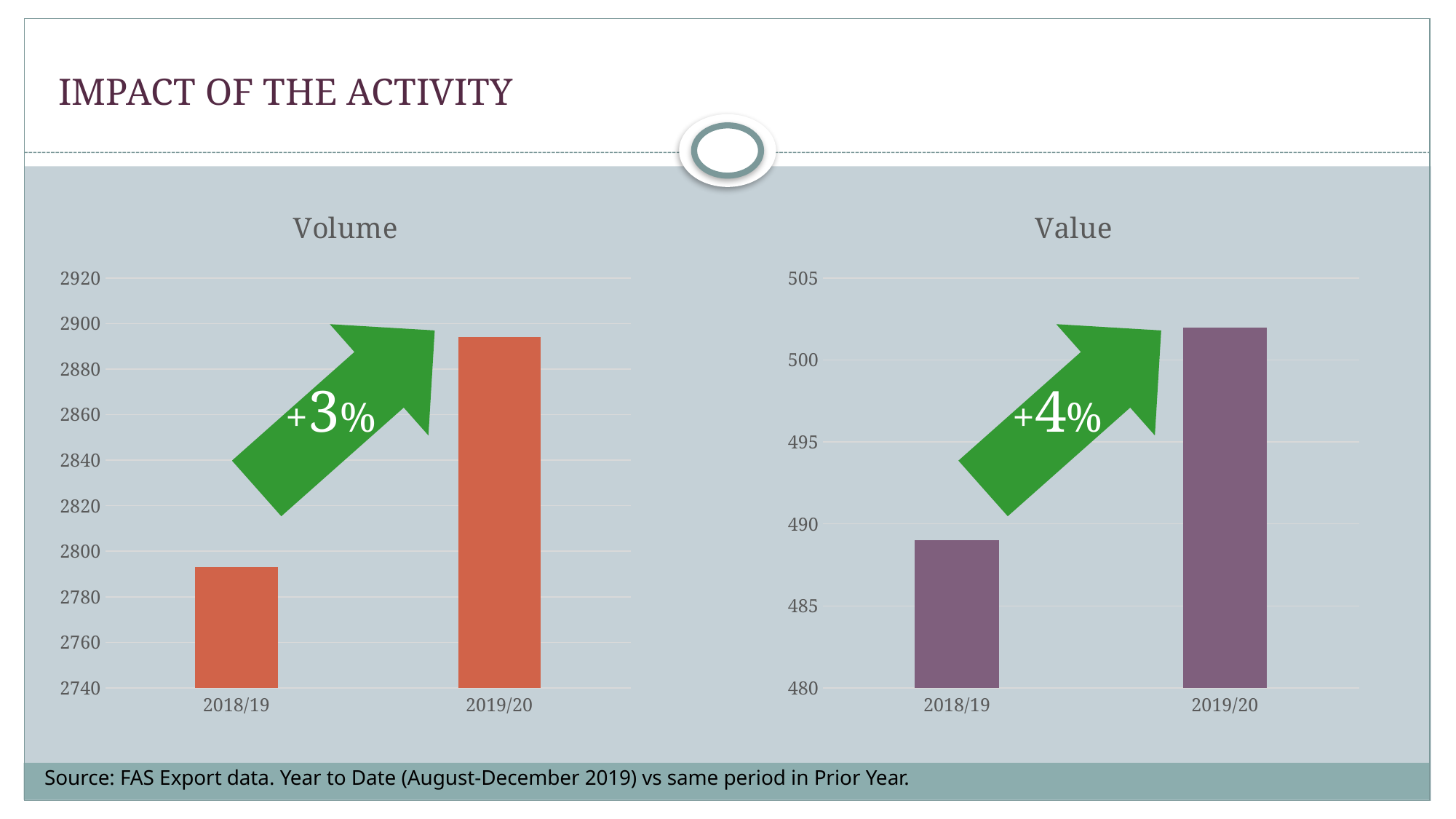
In the Value chart, is the value for 2019/20 greater or less than 500? greater In the Value chart, which year has the lower value? 2018/19 In the Volume chart, do the values rise or fall from 2018/19 to 2019/20? rise In the Volume chart, is the value for 2018/19 greater or less than 2800? less How many categories are shown on the x axis of the Value chart? 2 In the Value chart, is the bar for 2019/20 larger or smaller than the bar for 2018/19? larger In the Volume chart, which year has the higher value? 2019/20 What percentage change is printed on the green arrow in the Value chart? +4% What type of chart is the Volume chart? bar chart In the Value chart, is the value for 2018/19 greater or less than 485? greater What percentage change is printed on the green arrow in the Volume chart? +3%